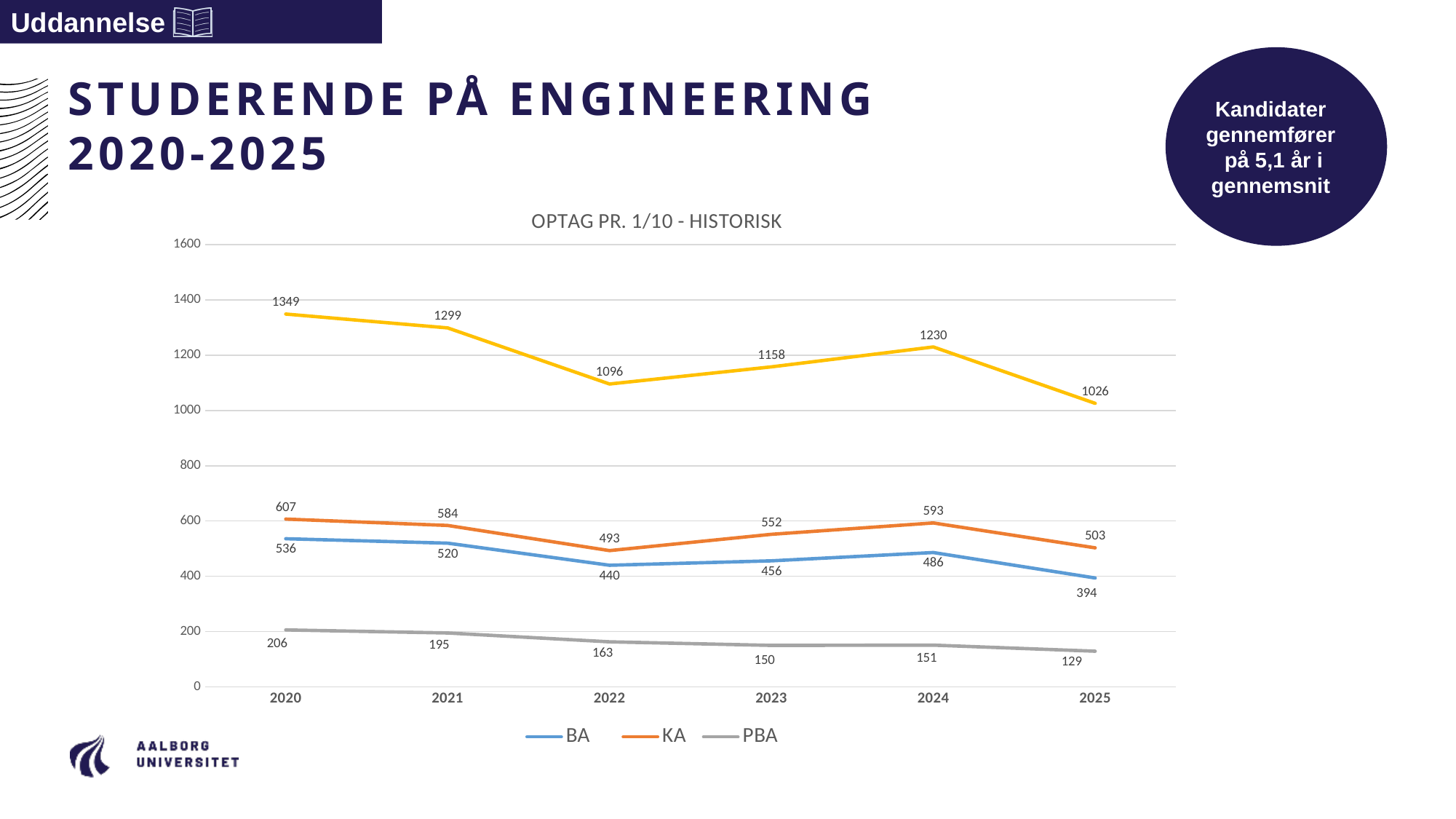
How many series does the legend list? 3 What is the title of the chart? OPTAG PR. 1/10 - HISTORISK In which year is the BA series highest? 2020 Is the value for BA in 2023 greater or less than 600? less In which year is the PBA series lowest? 2025 What kind of chart is this? line chart What is the value for BA in 2025? 394 How many years are shown on the x axis? 6 What is the difference between the KA values in 2024 and 2025? 90 Which is larger in 2022, the BA value or the KA value? KA What is the value for KA in 2020? 607 What is the value for PBA in 2023? 150